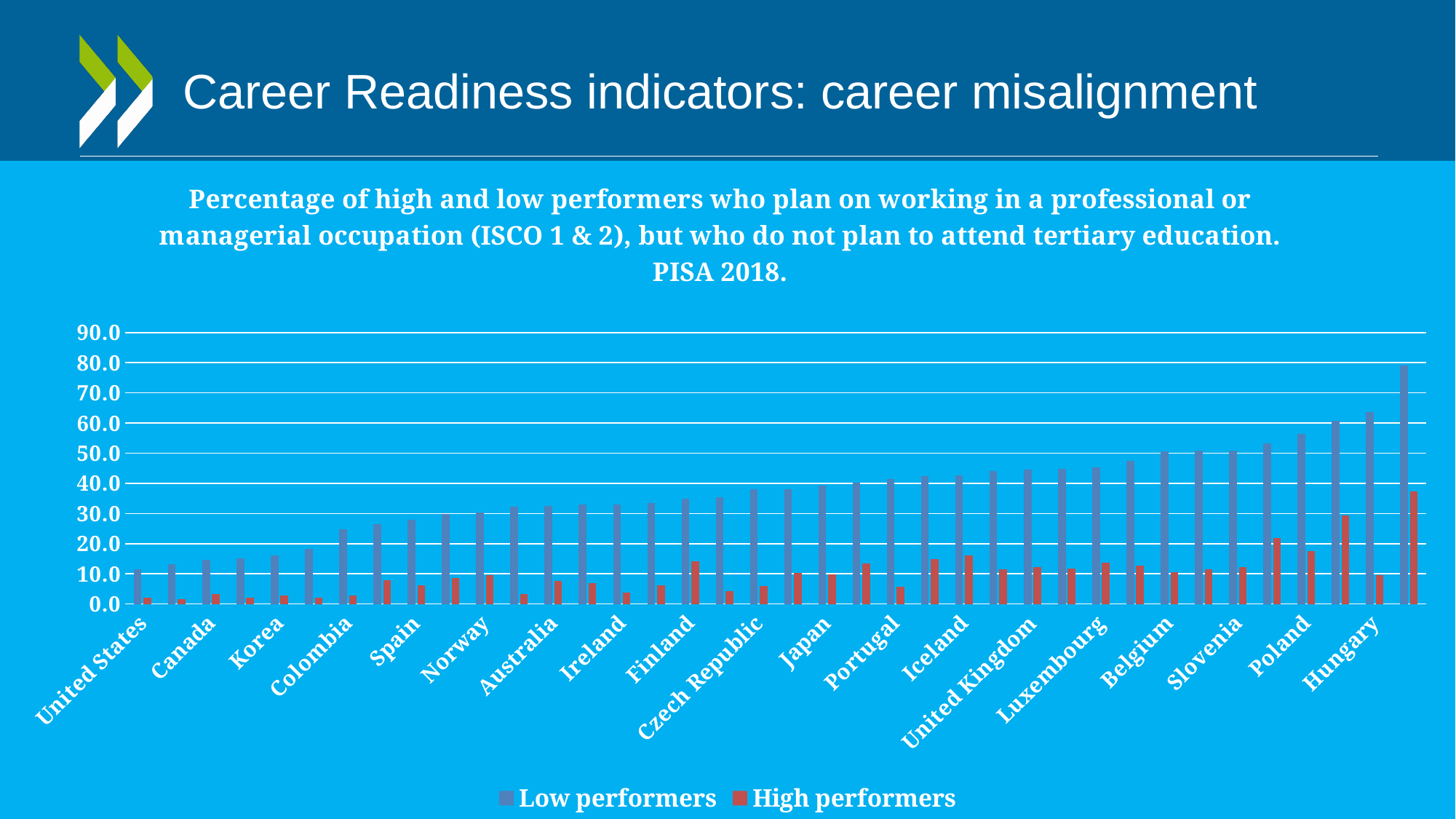
How many series does the legend list? 2 Which country has the larger Low performers value: the United States or Hungary? Hungary Which is larger for Hungary: the Low performers value or the High performers value? Low performers Which colour represents High performers in the chart? red Is the High performers value for Hungary greater or less than 20.0? less Do the Low performers values generally rise or fall moving from left to right along the x axis? rise What kind of chart is shown on the slide? bar chart Is the Low performers value for Hungary greater or less than 50.0? greater Is the Low performers value for Poland greater or less than 50.0? greater What are the two series named in the legend? Low performers and High performers